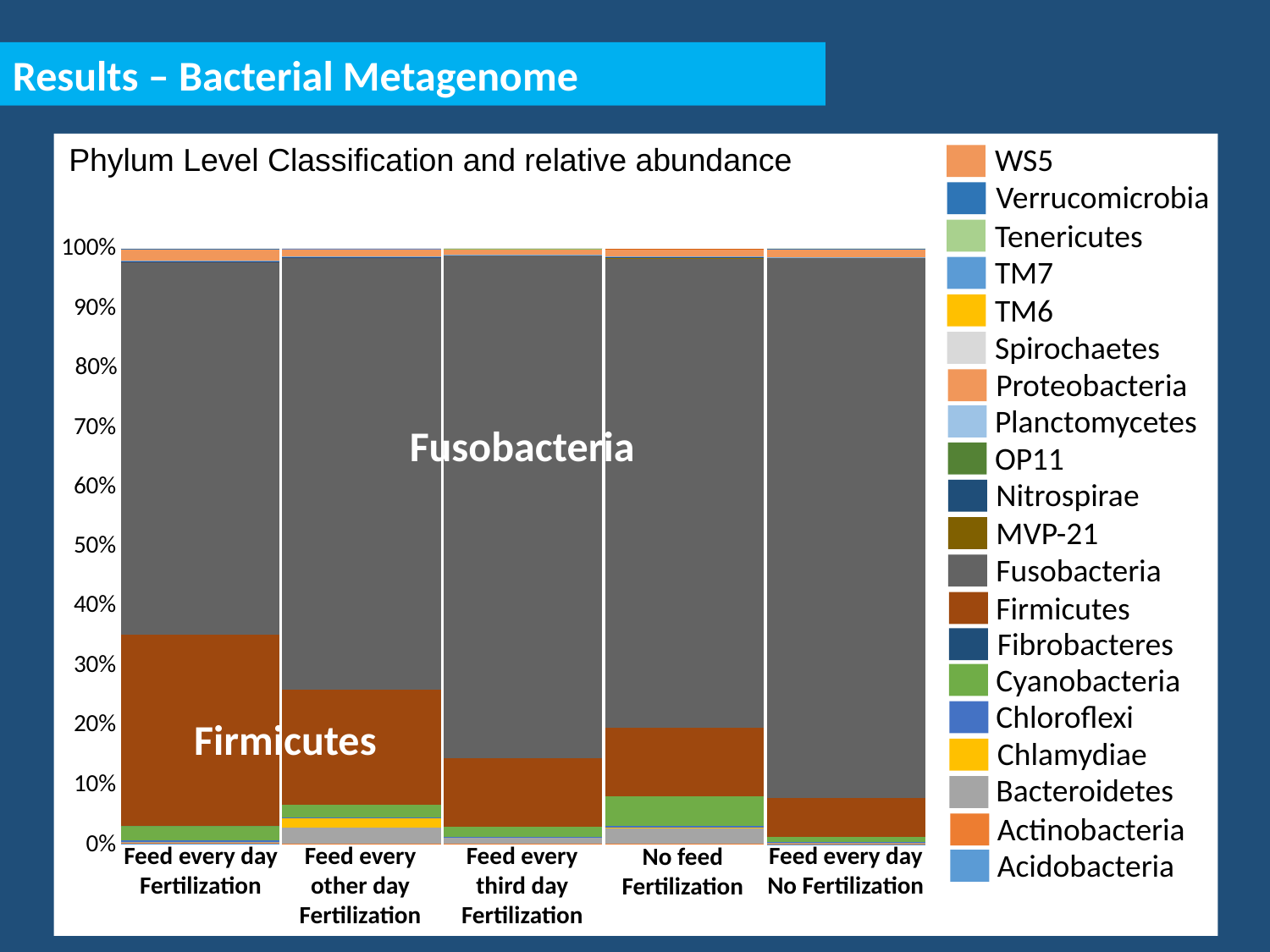
What is the title of the chart? Phylum Level Classification and relative abundance Is the Firmicutes share for Feed every day No Fertilization greater or less than 10%? less Is the Firmicutes share for Feed every day Fertilization greater or less than 20%? greater How many phyla does the legend list? 20 Is the Fusobacteria share for Feed every day No Fertilization greater or less than 80%? greater Which treatment has the largest Firmicutes segment? Feed every day Fertilization How many treatment categories are shown along the x axis? 5 Which treatment has the smallest Firmicutes segment? Feed every day No Fertilization Is the Firmicutes segment larger for Feed every day Fertilization or for No feed Fertilization? Feed every day Fertilization What kind of chart is shown on the slide? Stacked bar chart Which phylum makes up the largest share of every bar? Fusobacteria What is the maximum value shown on the y axis? 100%